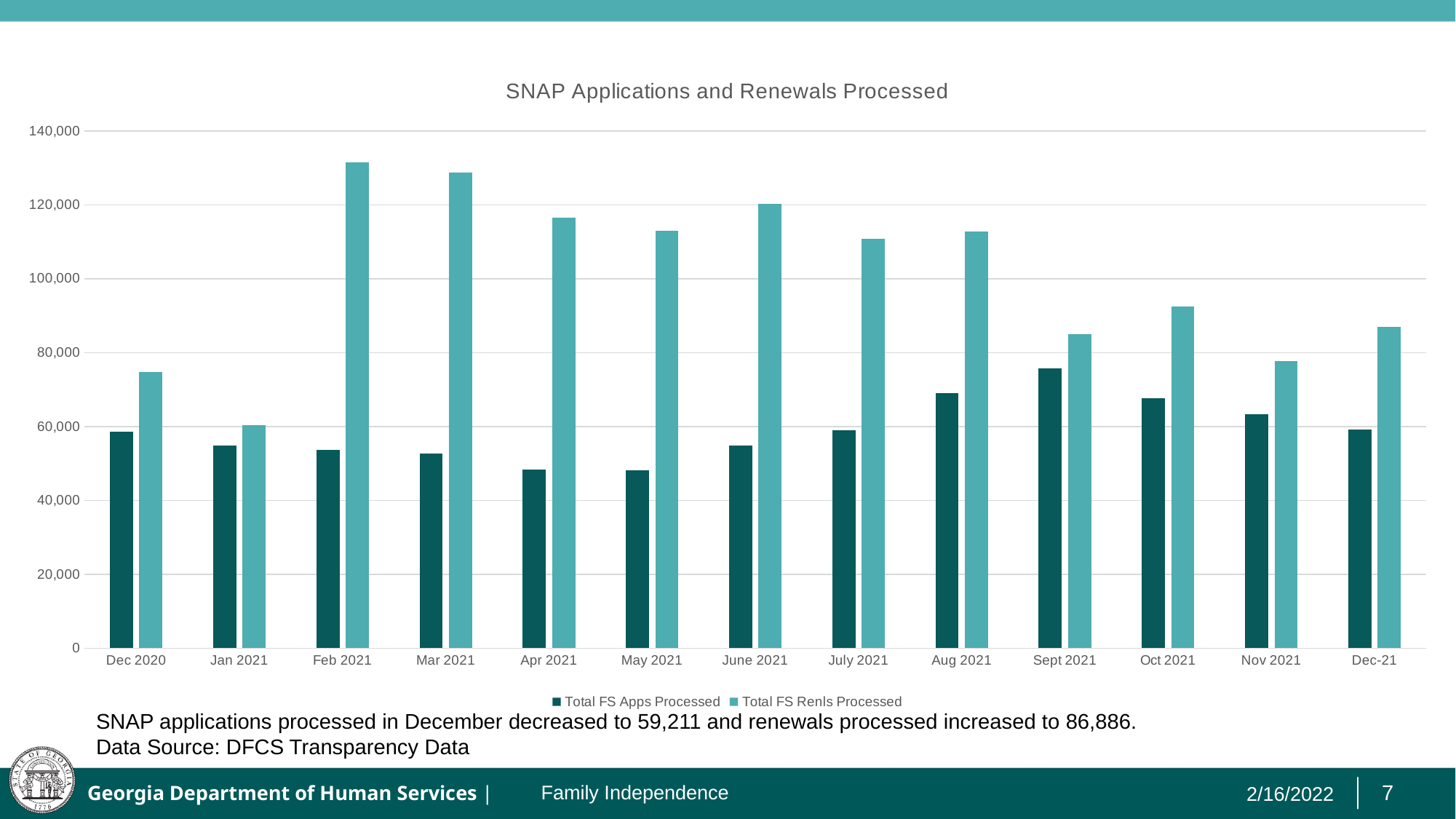
Which month has the highest value for Total FS Apps Processed? Sept 2021 What is the title of the chart? SNAP Applications and Renewals Processed How many months are shown on the x axis? 13 What is the value of Total FS Renls Processed for Dec-21? 86,886 What kind of chart is shown on the slide? bar chart Is the value for Total FS Renls Processed in Feb 2021 greater or less than 120,000? greater Which is larger in Feb 2021, Total FS Apps Processed or Total FS Renls Processed? Total FS Renls Processed Is the value for Total FS Apps Processed in Sept 2021 greater or less than 80,000? less How many series does the legend list? 2 Which month has the lowest value for Total FS Renls Processed? Jan 2021 What is the difference between renewals processed and applications processed in Dec-21? 27,675 What is the value of Total FS Apps Processed for Dec-21? 59,211